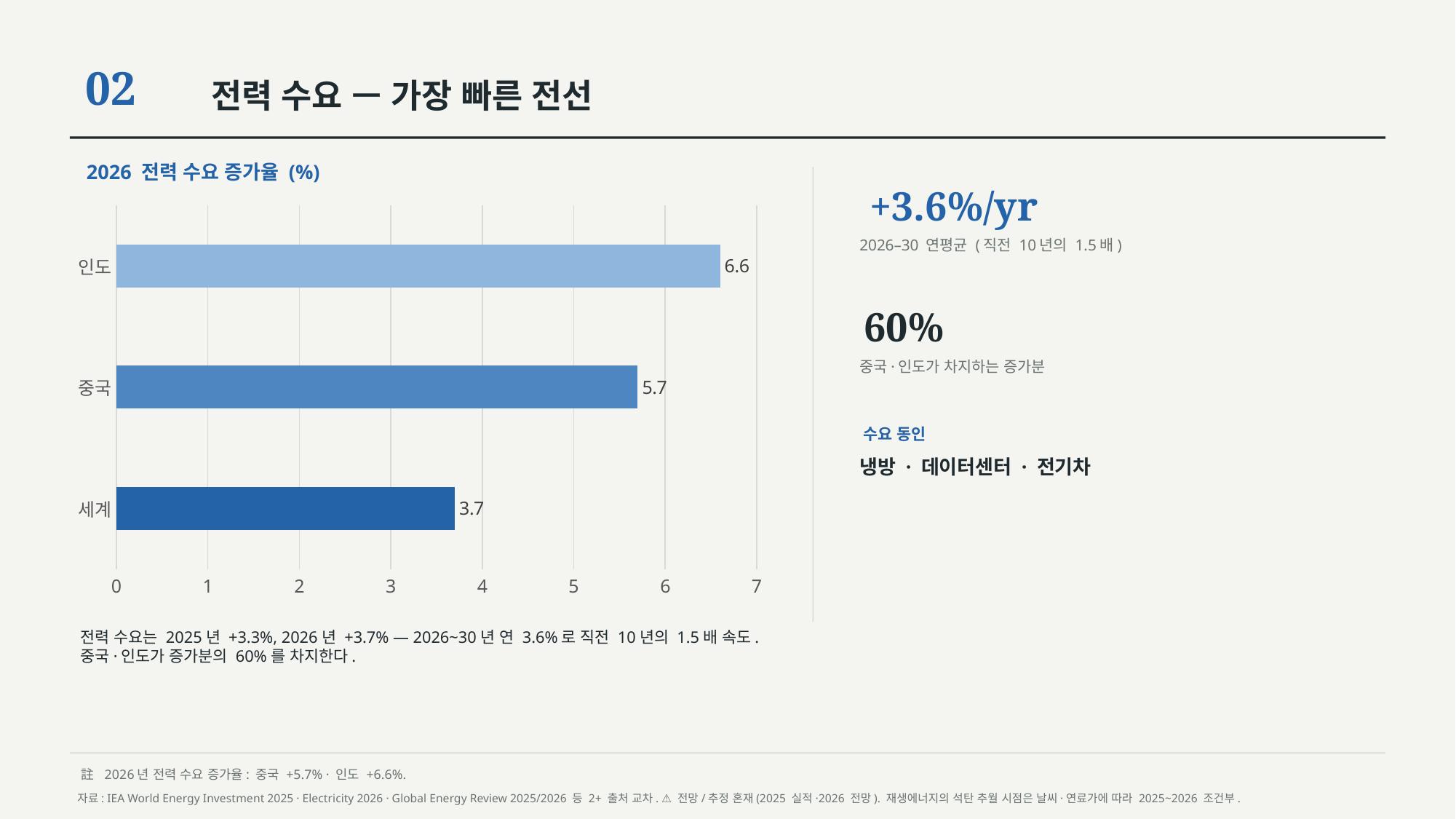
Which has a larger 2026 growth rate, 중국 or 세계? 중국 What is the 2026 electricity demand growth rate shown for 세계 (World)? 3.7 How many categories are shown in the chart? 3 What is the title of the chart? 2026 전력 수요 증가율 (%) What is the difference between the growth rates for 인도 and 세계? 2.9 What is the difference between the growth rates for 인도 and 중국? 0.9 What kind of chart is shown on the slide? bar chart Which category has the highest 2026 electricity demand growth rate? 인도 What is the 2026 electricity demand growth rate shown for 인도 (India)? 6.6 Is the value for 중국 greater or less than 5? greater Which category has the lowest 2026 electricity demand growth rate? 세계 What is the 2026 electricity demand growth rate shown for 중국 (China)? 5.7